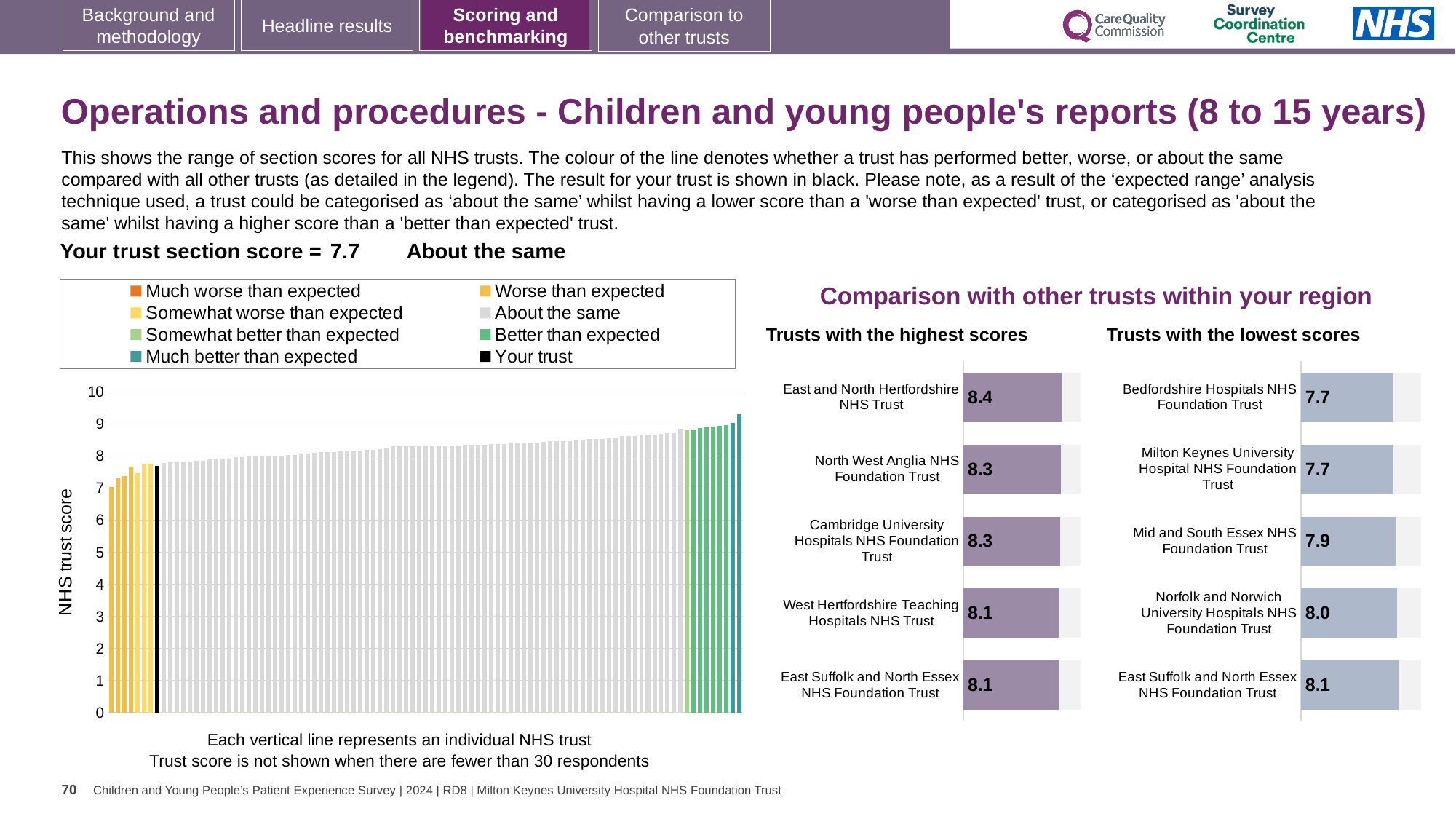
In the 'Trusts with the highest scores' chart, which trust has the highest score? East and North Hertfordshire NHS Trust In the 'Trusts with the highest scores' chart, what is the score for West Hertfordshire Teaching Hospitals NHS Trust? 8.1 In the 'Trusts with the lowest scores' chart, what is the score for Norfolk and Norwich University Hospitals NHS Foundation Trust? 8.0 In the 'Trusts with the highest scores' chart, what is the score for East and North Hertfordshire NHS Trust? 8.4 In the 'Trusts with the lowest scores' chart, what is the score for Mid and South Essex NHS Foundation Trust? 7.9 In the large chart on the left showing the range of section scores, do the values rise or fall from left to right along the x axis? rise In the 'Trusts with the lowest scores' chart, which trust has the highest score? East Suffolk and North Essex NHS Foundation Trust In the 'Trusts with the lowest scores' chart, what is the difference between the scores of East Suffolk and North Essex NHS Foundation Trust and Bedfordshire Hospitals NHS Foundation Trust? 0.4 In the 'Trusts with the highest scores' chart, what is the difference between the scores of East and North Hertfordshire NHS Trust and East Suffolk and North Essex NHS Foundation Trust? 0.3 What is the y-axis label of the large chart on the left showing the range of section scores? NHS trust score How many trusts are shown in the 'Trusts with the highest scores' chart? 5 In the 'Trusts with the lowest scores' chart, which has the larger score: Mid and South Essex NHS Foundation Trust or Norfolk and Norwich University Hospitals NHS Foundation Trust? Norfolk and Norwich University Hospitals NHS Foundation Trust